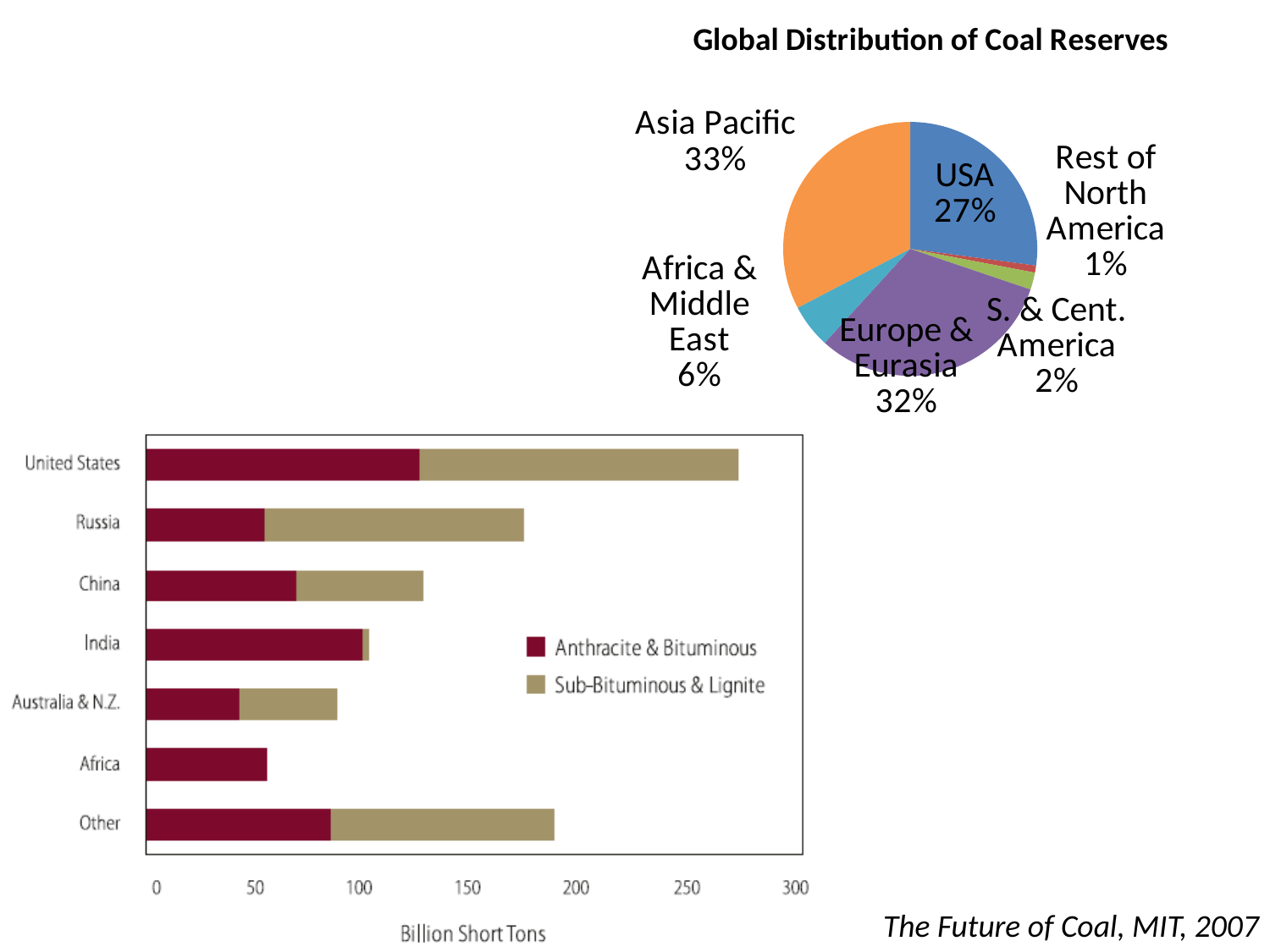
How many series does the legend of the bar chart in the lower left of the slide list? 2 How many slices does the pie chart titled 'Global Distribution of Coal Reserves' have? 6 In the pie chart titled 'Global Distribution of Coal Reserves', how many percentage points larger is the USA share than the Africa & Middle East share? 21 In the bar chart in the lower left of the slide, is the total value for United States greater or less than 250 billion short tons? greater In the pie chart titled 'Global Distribution of Coal Reserves', which region has the largest share? Asia Pacific In the pie chart titled 'Global Distribution of Coal Reserves', which region has the smallest share? Rest of North America In the bar chart in the lower left of the slide, which country has the longest total bar? United States In the pie chart titled 'Global Distribution of Coal Reserves', what share is shown for Europe & Eurasia? 32% In the pie chart titled 'Global Distribution of Coal Reserves', which is larger: the share for USA or the share for Europe & Eurasia? Europe & Eurasia In the bar chart in the lower left of the slide, is the total value for Australia & N.Z. greater or less than 100 billion short tons? less What kind of chart is the chart in the lower left of the slide with the axis 'Billion Short Tons'? Stacked bar chart In the pie chart titled 'Global Distribution of Coal Reserves', what share of coal reserves does Asia Pacific hold? 33%